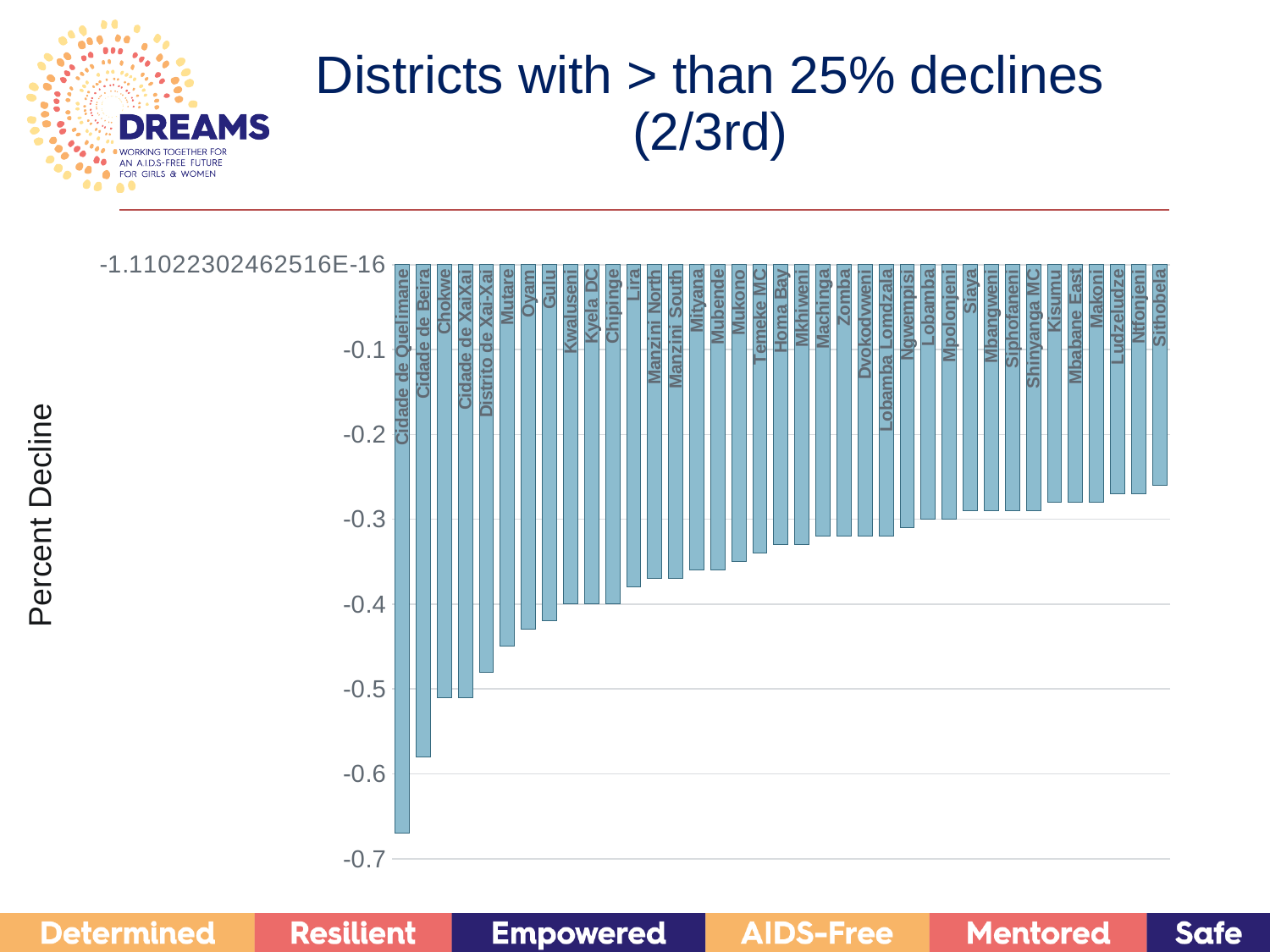
Is the value for Lira greater or less than -0.4? greater How many districts are plotted in the chart? 37 Which district has the largest (most negative) percent decline? Cidade de Quelimane What is the label on the vertical axis of the chart? Percent Decline Is the value for Mutare greater or less than -0.5? greater What kind of chart is shown on the slide? bar chart Do the bar values rise or fall (become less negative or more negative) moving from left to right along the x axis? rise Is the value for Cidade de Quelimane greater or less than -0.6? less Which district has a larger decline, Cidade de Beira or Gulu? Cidade de Beira Which district has the smallest (least negative) percent decline? Sithobela